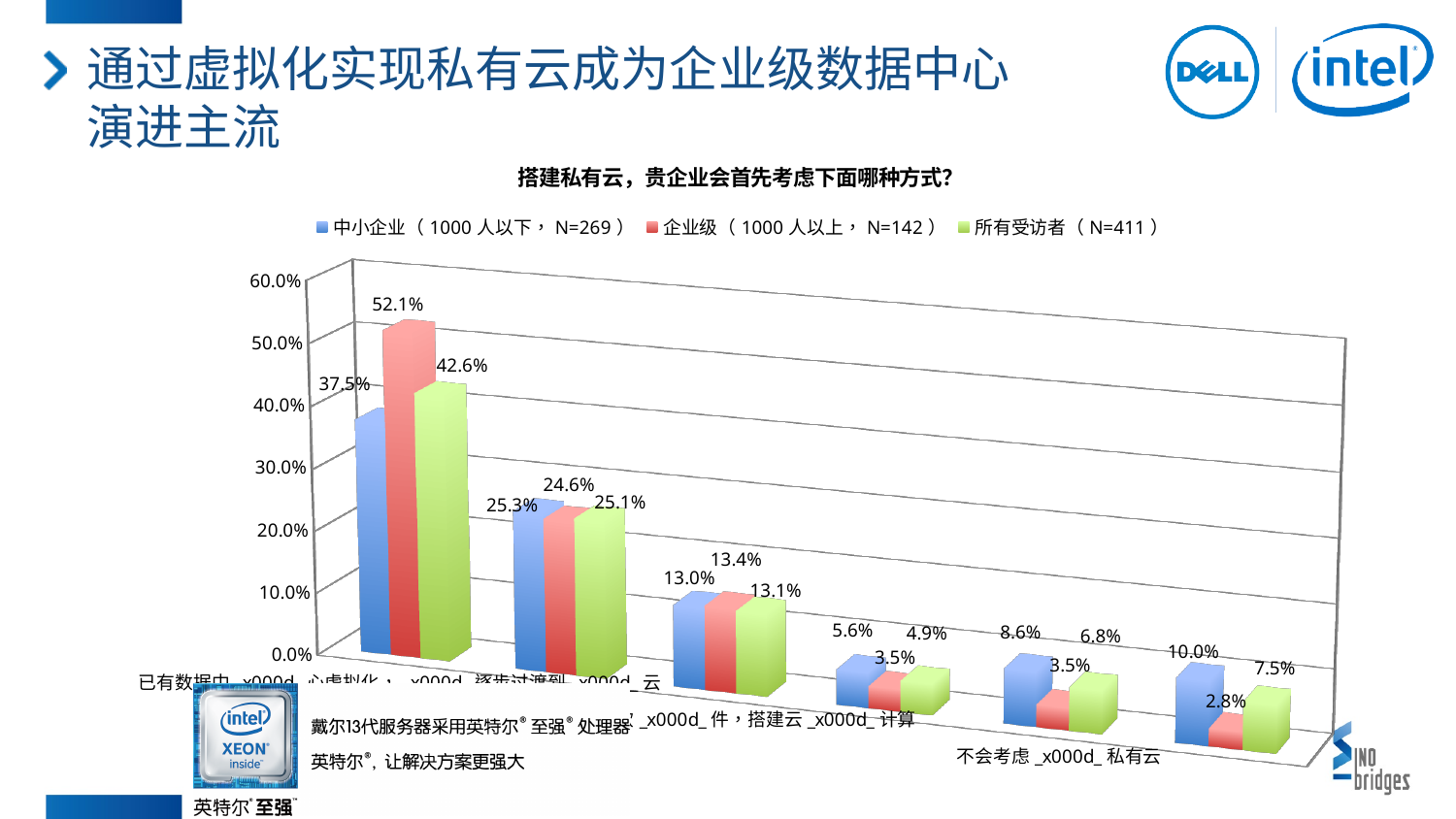
What is the difference between the 企业级 value and the 中小企业 value in the leftmost category? 14.6% In the 不会考虑私有云 category, which is larger: the 中小企业 value or the 所有受访者 value? 中小企业 What is the value for 中小企业（1000人以下，N=269） in the 不会考虑私有云 category? 8.6% What is the value for 企业级（1000人以上，N=142） in the leftmost category of the chart? 52.1% What is the value for 所有受访者（N=411） in the leftmost category of the chart? 42.6% How many series does the chart legend list? 3 Which series has the highest value in the leftmost category of the chart? 企业级（1000人以上，N=142） What is the title of the chart? 搭建私有云，贵企业会首先考虑下面哪种方式? What kind of chart is shown on the slide? bar chart Which series has the lowest value in the 不会考虑私有云 category? 企业级（1000人以上，N=142） What is the value for 企业级（1000人以上，N=142） in the 不会考虑私有云 category? 3.5% How many categories are plotted along the x axis of the chart? 6